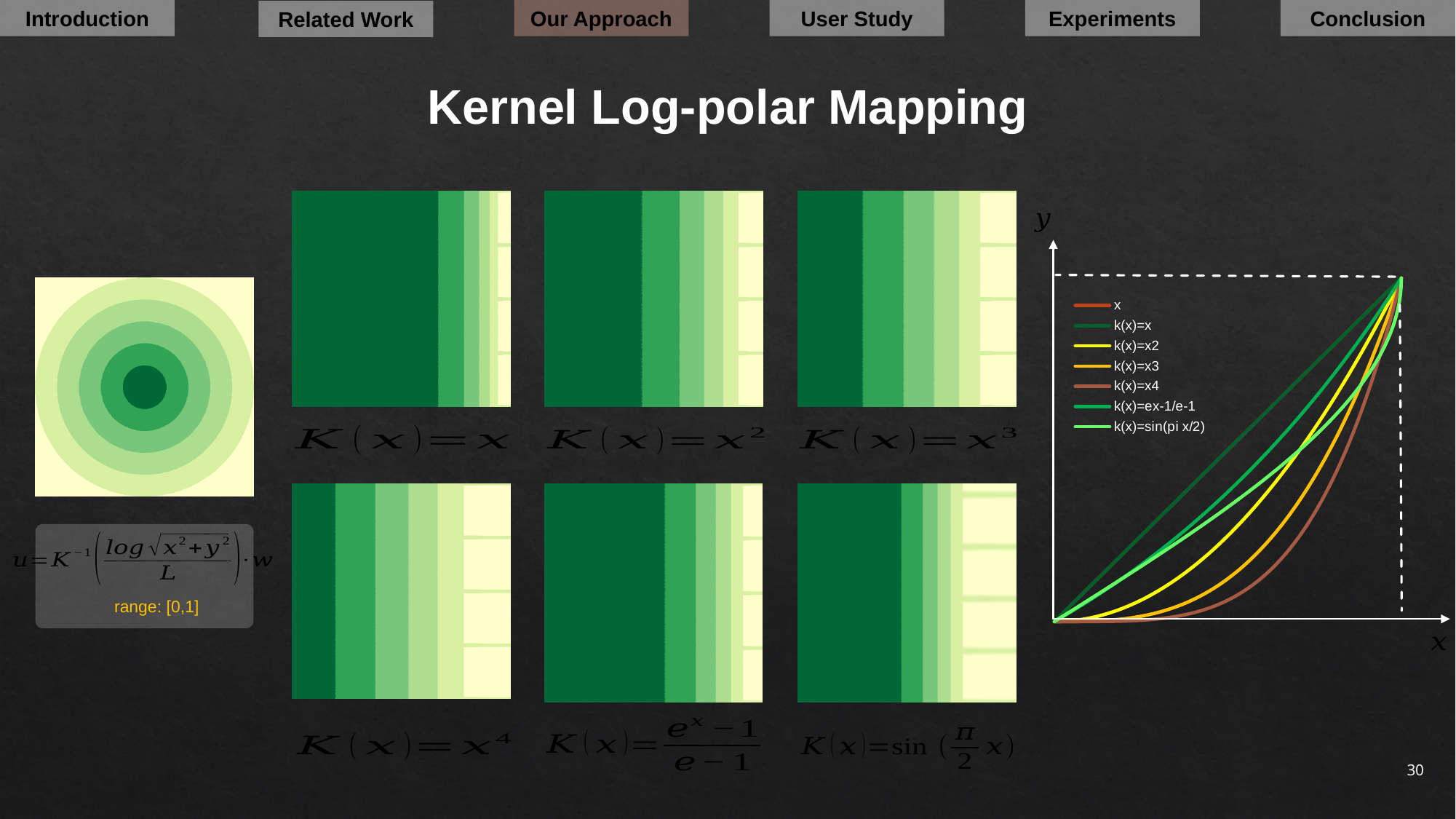
In the line chart on the right, which curve is higher in the middle of the x range: k(x)=x2 or k(x)=x4? k(x)=x2 What is the label on the vertical axis of the line chart on the right? y What kind of chart is shown on the right side of the slide? line chart In the line chart on the right, do the curves rise or fall as x increases? rise In the line chart on the right, which curve is higher in the middle of the x range: k(x)=sin(pi x/2) or k(x)=x3? k(x)=sin(pi x/2) In the line chart on the right, which curve is higher in the middle of the x range: k(x)=x3 or k(x)=x4? k(x)=x3 What is the last entry listed in the legend of the line chart on the right? k(x)=sin(pi x/2) In the line chart on the right, which curve lies lowest in the middle of the x range? k(x)=x4 What is the label on the horizontal axis of the line chart on the right? x How many entries does the legend of the line chart on the right list? 7